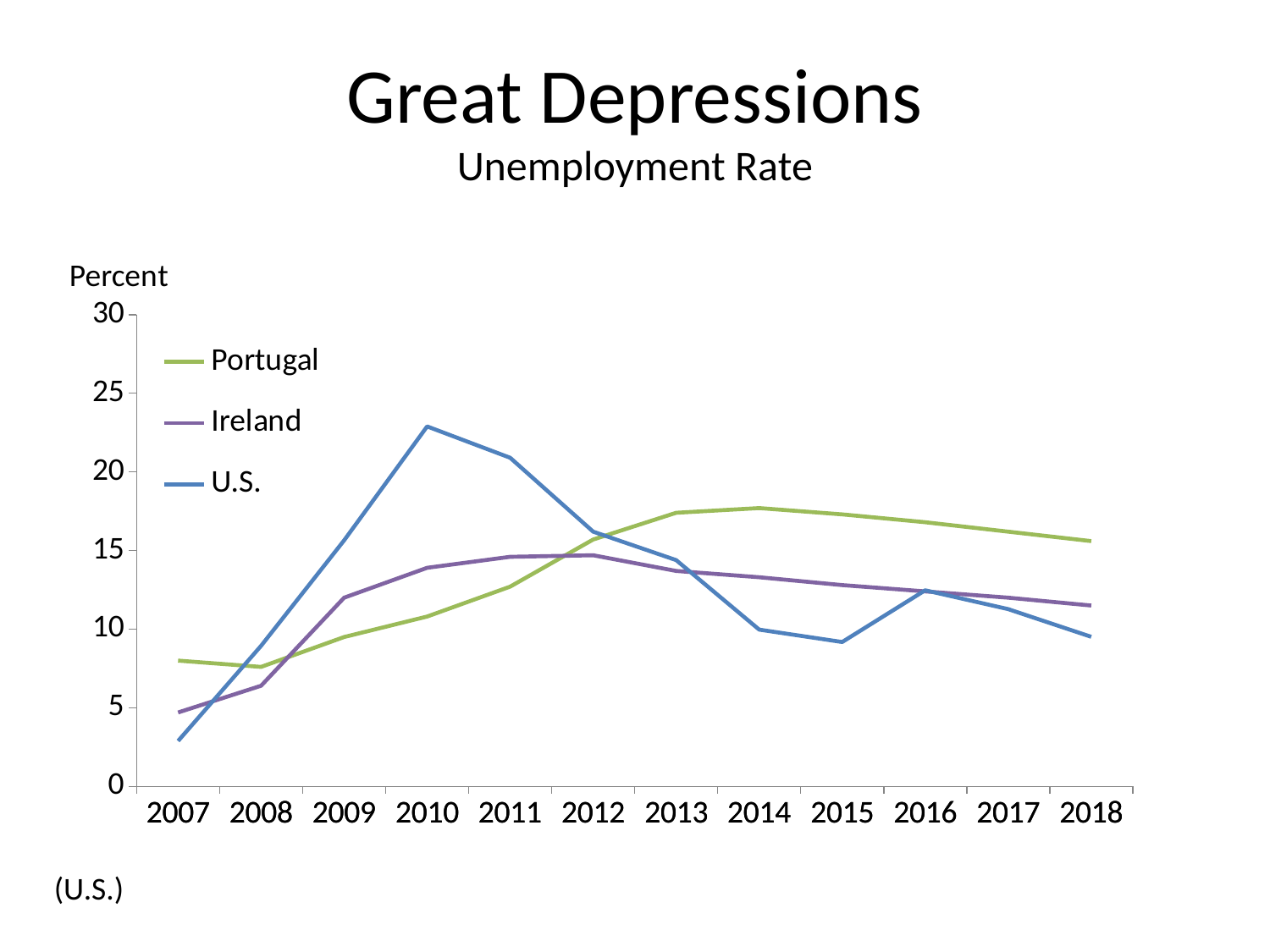
Is the value for U.S. in 2010 greater or less than 20? greater Does the U.S. line rise or fall from 2007 to 2010? rise What is the label on the vertical axis? Percent How many years are shown on the x axis? 12 In 2014, which is larger, the value for Portugal or the value for U.S.? Portugal In which year does the U.S. line reach its peak? 2010 Is the value for Portugal in 2007 greater or less than 10? less Which series has the lowest value in 2007? U.S. How many series does the legend list? 3 Is the value for Ireland in 2009 greater or less than 10? greater Which series has the highest value in 2010? U.S. What kind of chart is shown on the slide? line chart